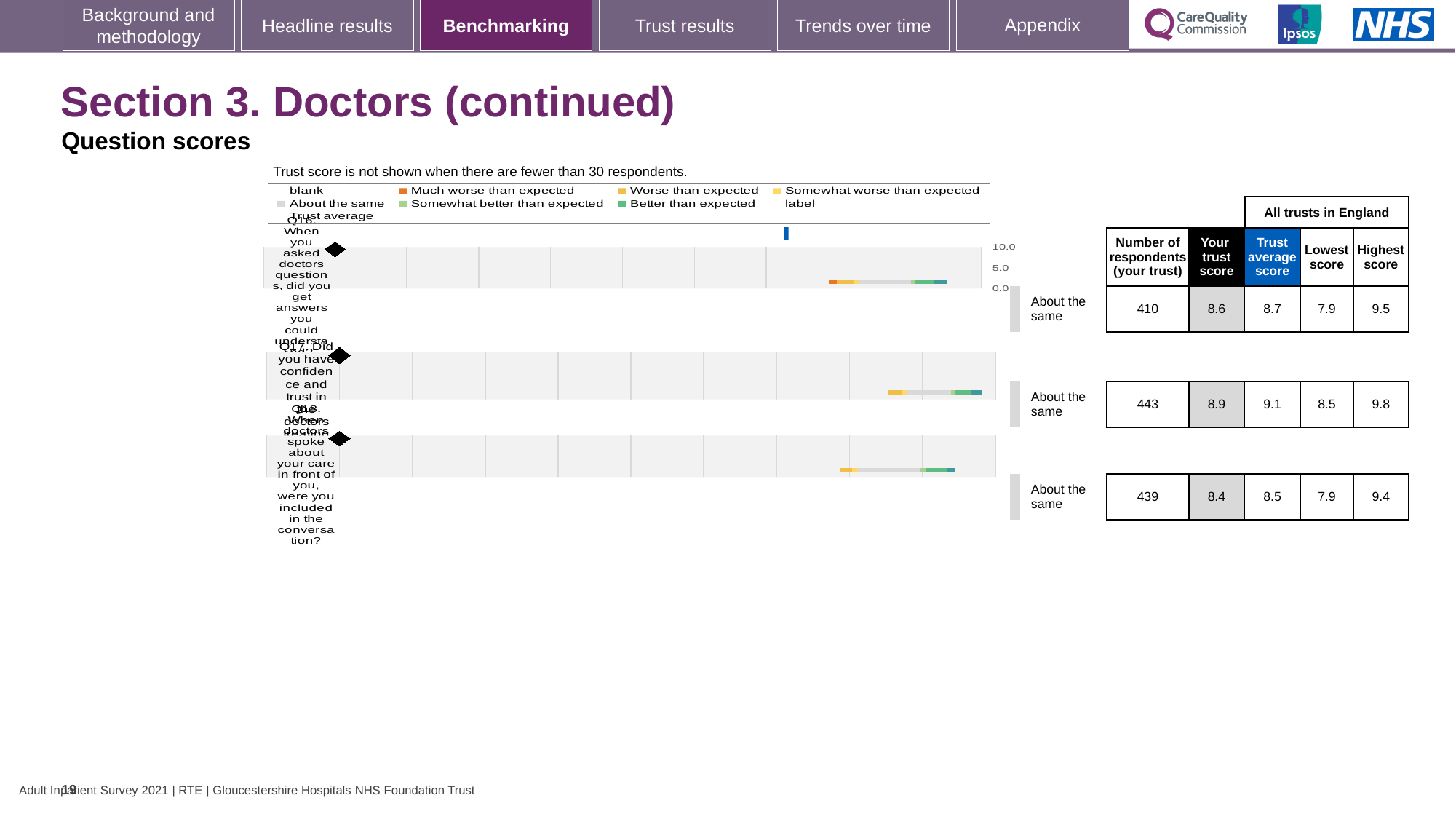
What is the lowest score across all trusts in England for Q18? 7.9 Which question has the highest trust score for this trust? Q17 How many respondents answered Q18 at this trust? 439 Which question has the lowest trust score for this trust? Q18 What is the difference between the highest score and the lowest score for Q16? 1.6 How many questions are plotted on the chart? 3 Which is larger for Q18: the trust score or the trust average score? Trust average score What kind of chart is shown on the slide? Bar chart What is the highest score across all trusts in England for Q17? 9.8 What is the trust average score for Q16 (When you asked doctors questions, did you get answers you could understand)? 8.7 What is the trust score for Q17 (Did you have confidence and trust in the doctors treating you)? 8.9 What benchmark rating is shown for Q16, Q17 and Q18? About the same